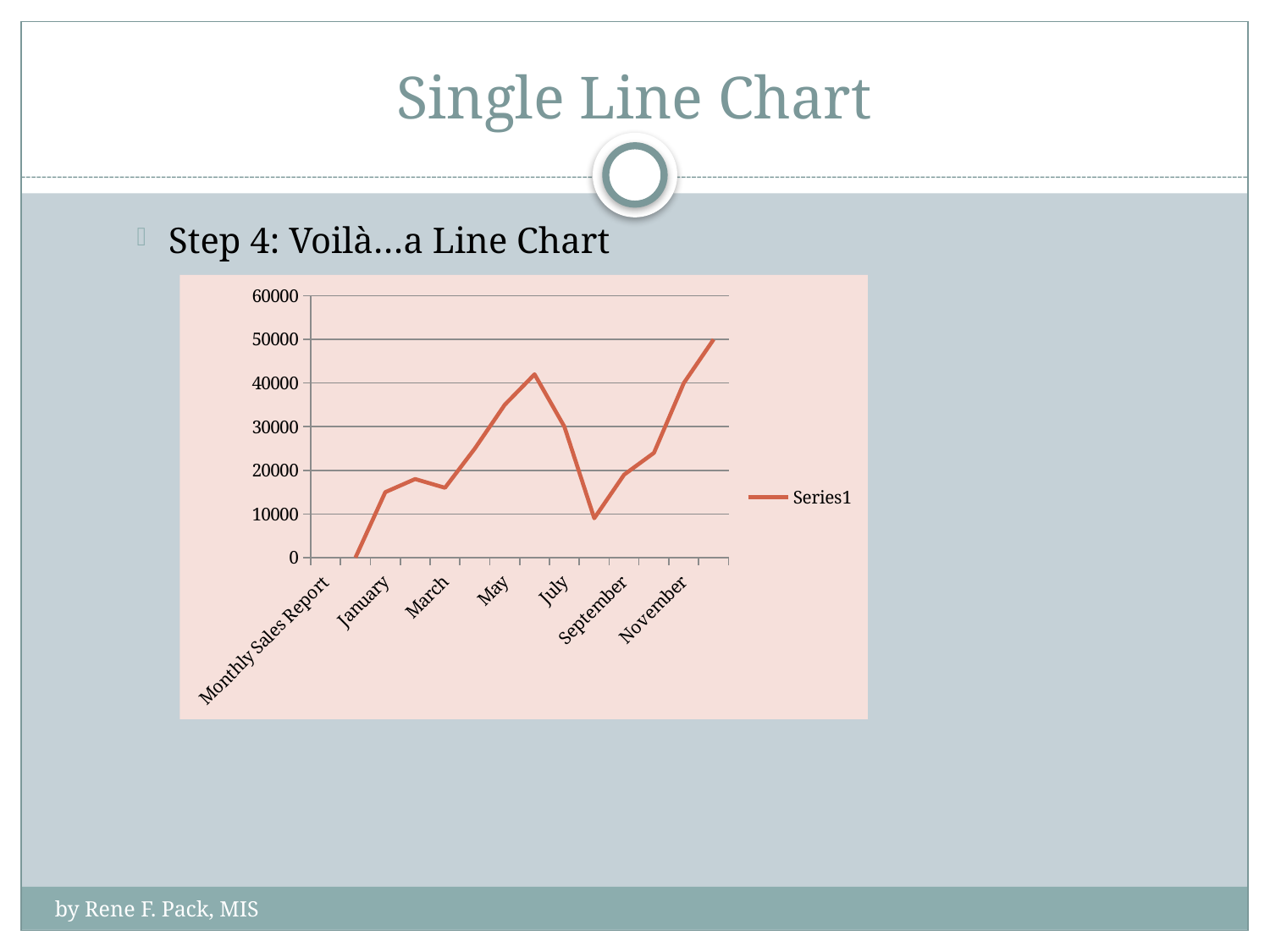
Is the value for May greater or less than 30000? greater Is the value for January greater or less than 10000? greater Which is larger, the value for July or the value for September? July Is the value for November greater or less than 30000? greater Do the values rise or fall from March to May? rise Which is larger, the value for November or the value for January? November How many series does the legend list? 1 What kind of chart is shown on the slide? line chart What is the name of the series shown in the legend? Series1